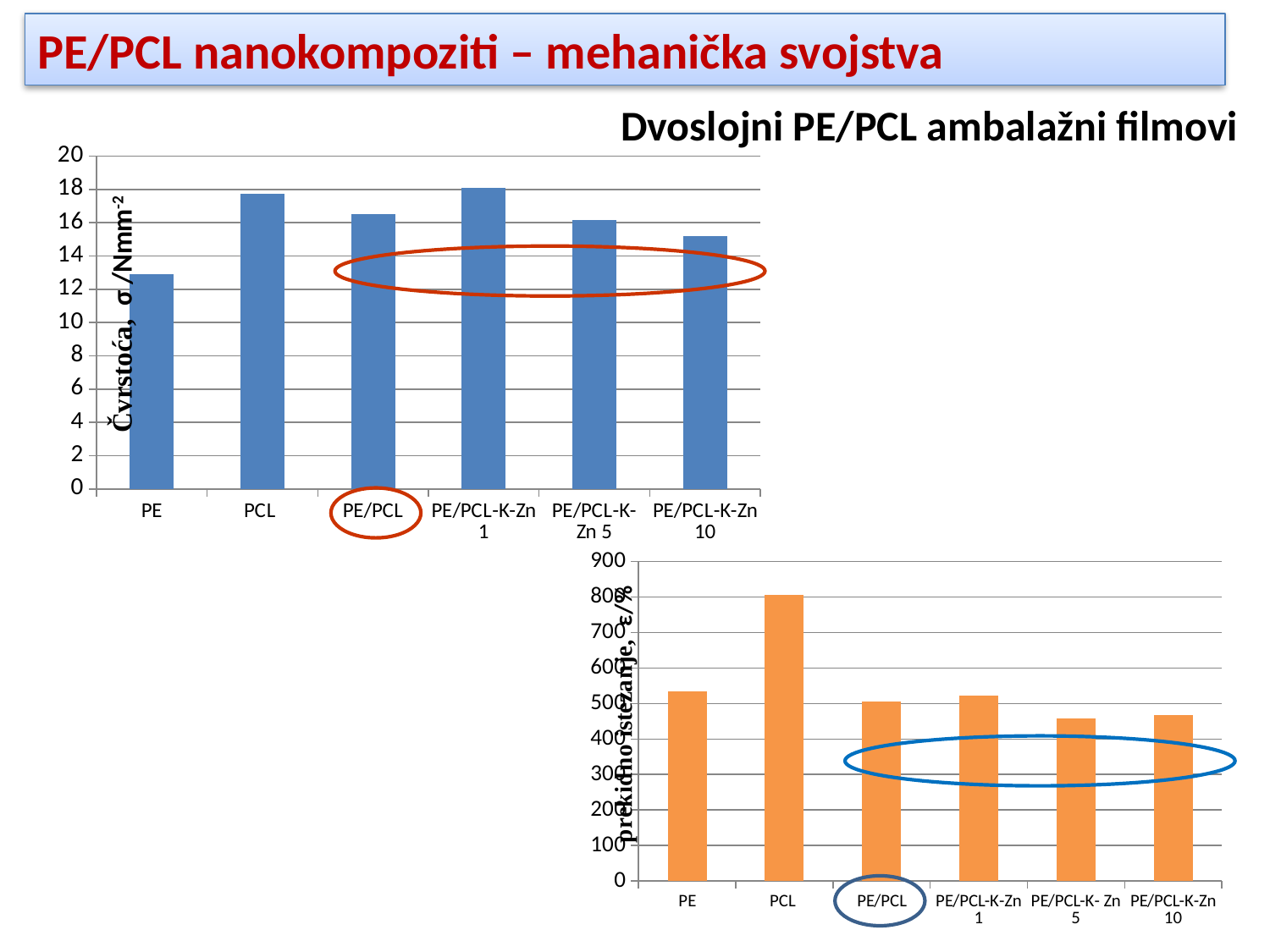
In the top-left chart (Čvrstoća), is the value for PE greater or less than 14? less What colour are the bars in the bottom-right chart (prekidno istezanje)? orange How many categories are shown on the x axis of the bottom-right chart (prekidno istezanje)? 6 In the bottom-right chart (prekidno istezanje), which category has the highest value? PCL What is the y-axis label of the top-left chart? Čvrstoća, σ/Nmm⁻² What kind of chart is the top-left chart (Čvrstoća)? bar chart In the top-left chart (Čvrstoća), which is larger, the value for PE/PCL or the value for PE/PCL-K-Zn 10? PE/PCL In the bottom-right chart (prekidno istezanje), is the value for PCL greater or less than 700? greater In the top-left chart (Čvrstoća), which category has the lowest value? PE In the top-left chart (Čvrstoća), is the value for PCL greater or less than 16? greater In the bottom-right chart (prekidno istezanje), which is larger, the value for PE or the value for PE/PCL-K-Zn 5? PE